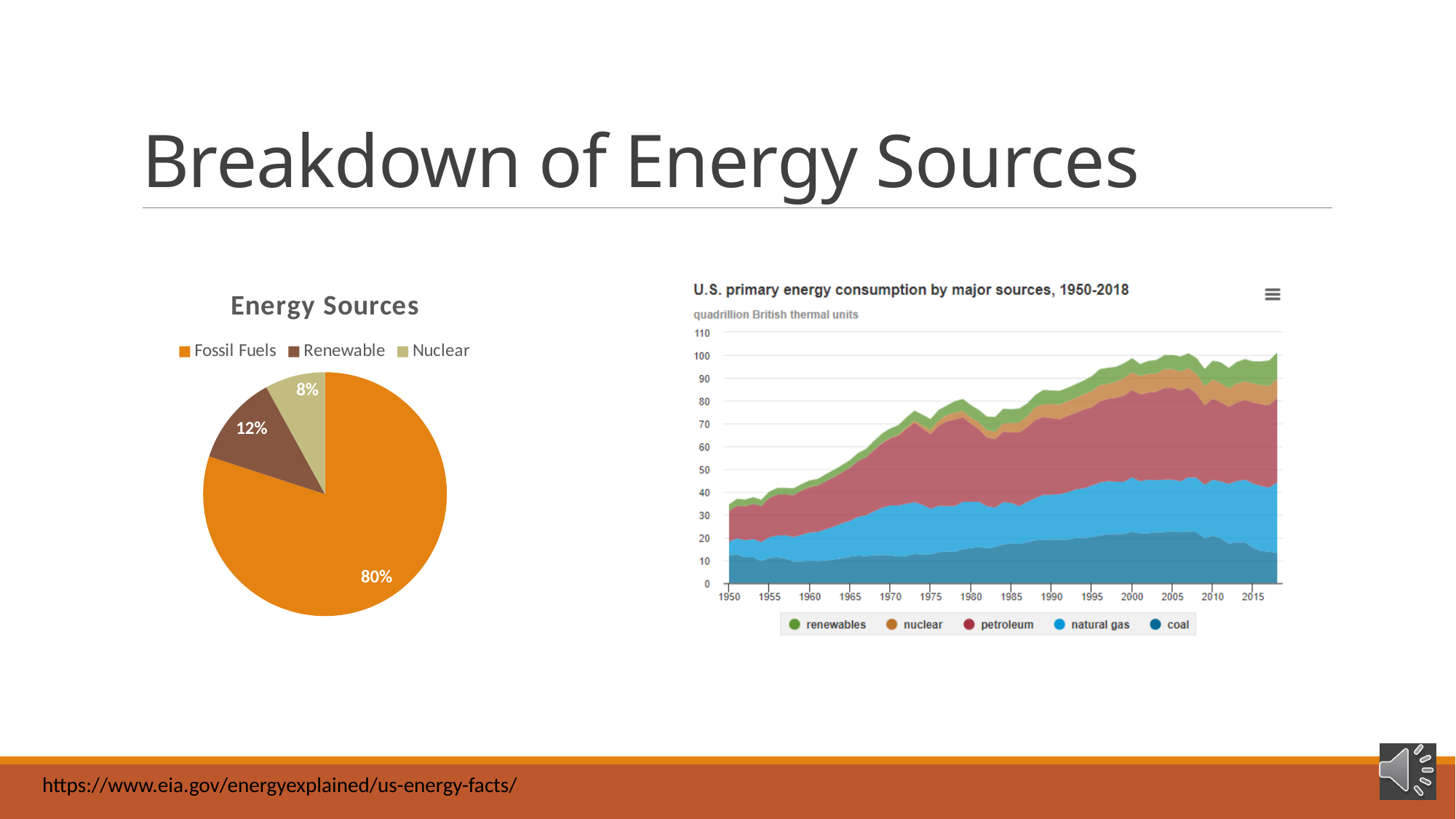
In the "Energy Sources" pie chart, which category has the smallest slice? Nuclear In the "U.S. primary energy consumption by major sources, 1950-2018" chart, does total consumption generally rise or fall from 1950 to 2018? Rise What unit is shown on the y axis of the "U.S. primary energy consumption by major sources, 1950-2018" chart? quadrillion British thermal units In the "Energy Sources" pie chart, what is the difference in percentage points between Fossil Fuels and Renewable? 68 In the "Energy Sources" pie chart, what share is Fossil Fuels? 80% In the "Energy Sources" pie chart, what share is Renewable? 12% In the "Energy Sources" pie chart, which category has the largest slice? Fossil Fuels In the "Energy Sources" pie chart, what share is Nuclear? 8% What kind of chart is the "Energy Sources" chart on the left? Pie chart How many categories does the "Energy Sources" pie chart show? 3 How many series does the legend of the "U.S. primary energy consumption by major sources, 1950-2018" chart list? 5 In the "Energy Sources" pie chart, which is larger, Renewable or Nuclear? Renewable